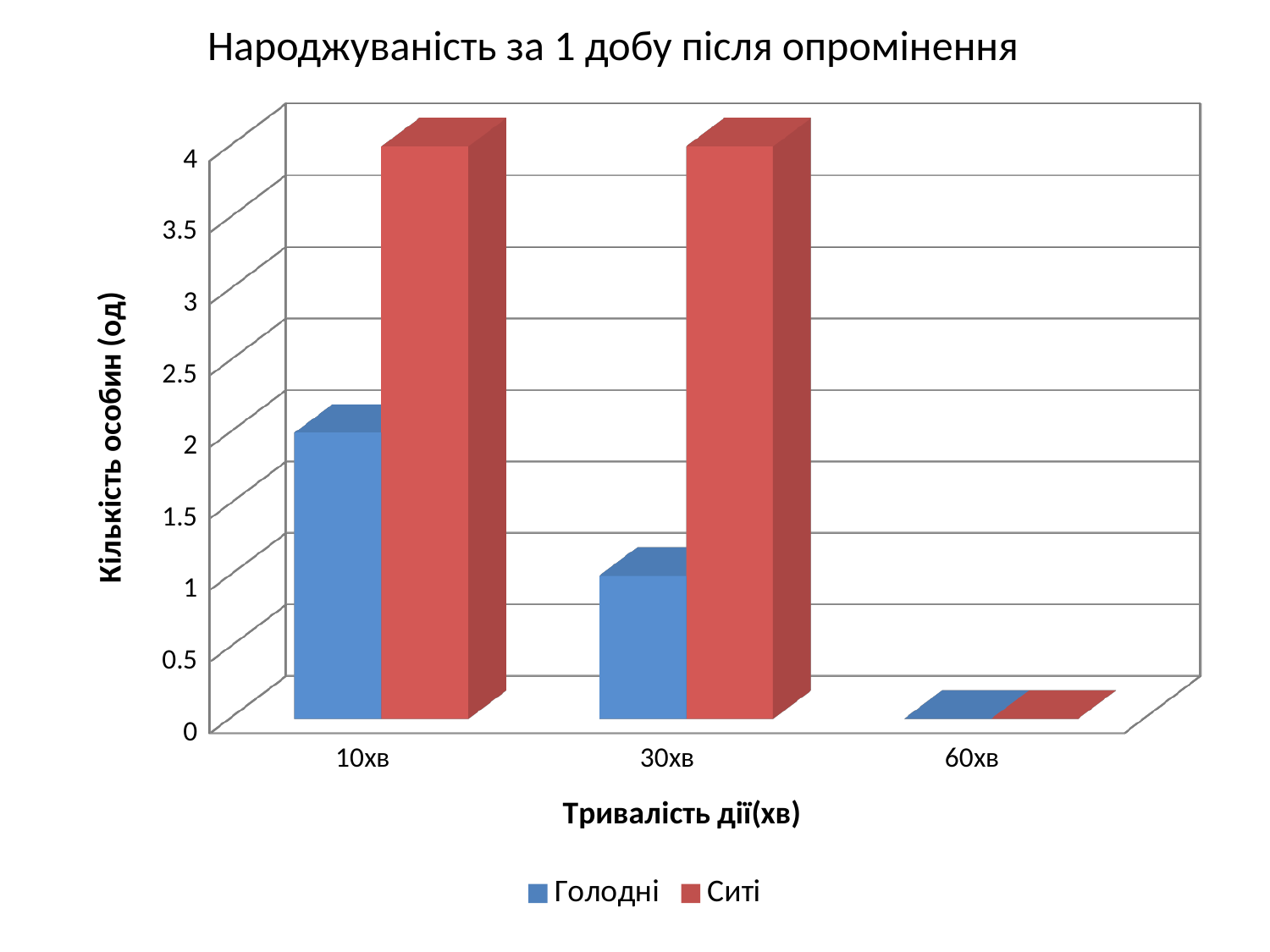
Is the value for Ситі at 30хв greater or less than 3? greater Which category has the lowest value for Голодні? 60хв What is the value for Голодні at 30хв? 1 Which is larger at 30хв, Голодні or Ситі? Ситі How many series does the legend list? 2 What kind of chart is shown on the slide? bar chart What is the value for Голодні at 10хв? 2 What is the title of the chart? Народжуваність за 1 добу після опромінення How many categories are shown on the x axis? 3 Do the values for Голодні rise or fall from 10хв to 60хв? fall What is the value for Ситі at 60хв? 0 What is the value for Ситі at 10хв? 4